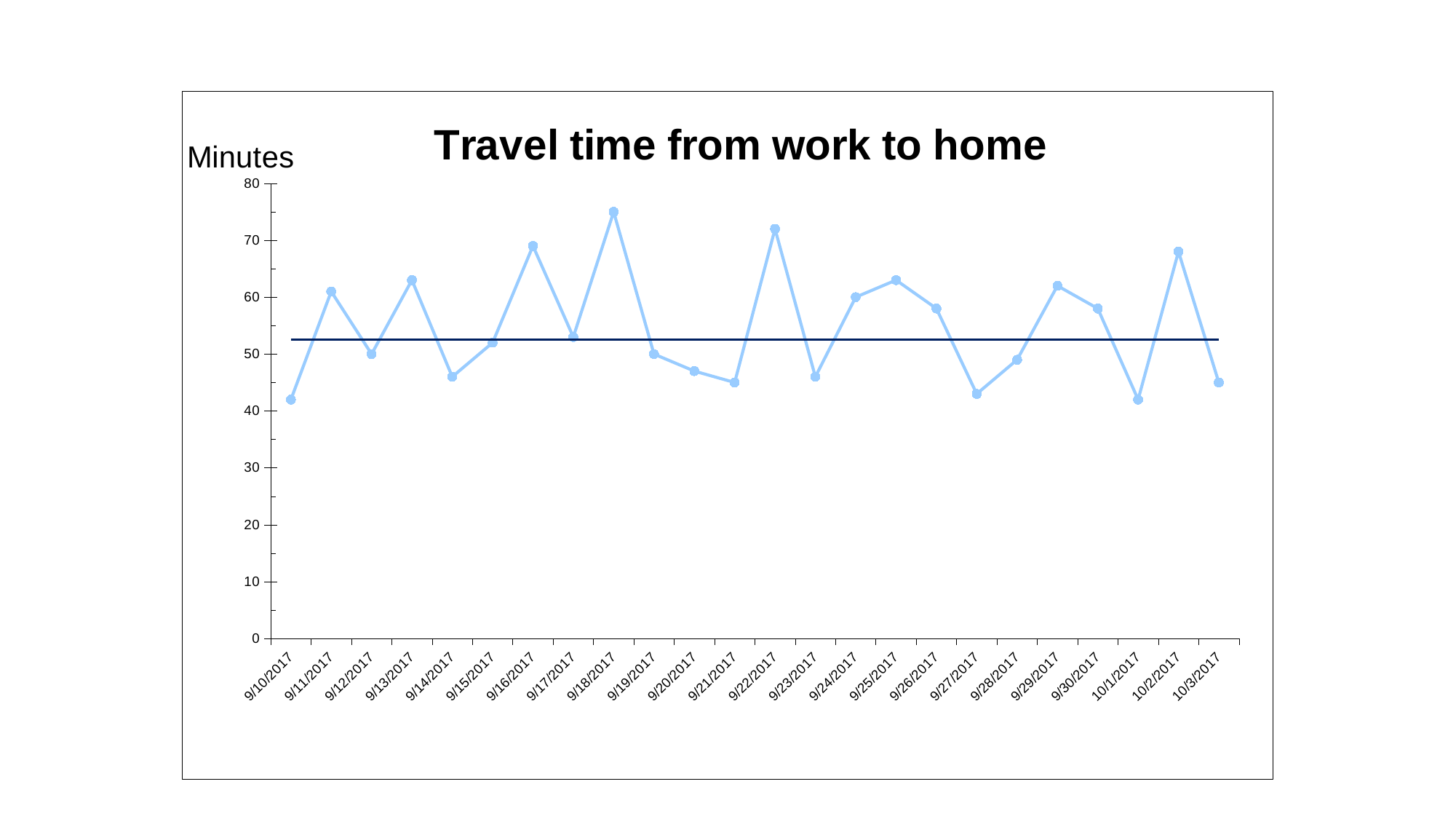
What is the title of the chart? Travel time from work to home Is the value for 9/18/2017 greater or less than 70? greater On which date is the travel time highest? 9/18/2017 Is the value for 10/2/2017 greater or less than 60? greater What kind of chart is shown on the slide? line chart How many dates are plotted on the x axis? 24 Which is larger, the value for 9/16/2017 or the value for 9/13/2017? 9/16/2017 Is the value for 9/16/2017 greater or less than 60? greater What unit is shown on the vertical axis label? Minutes Does the travel time rise or fall from 9/14/2017 to 9/16/2017? rise